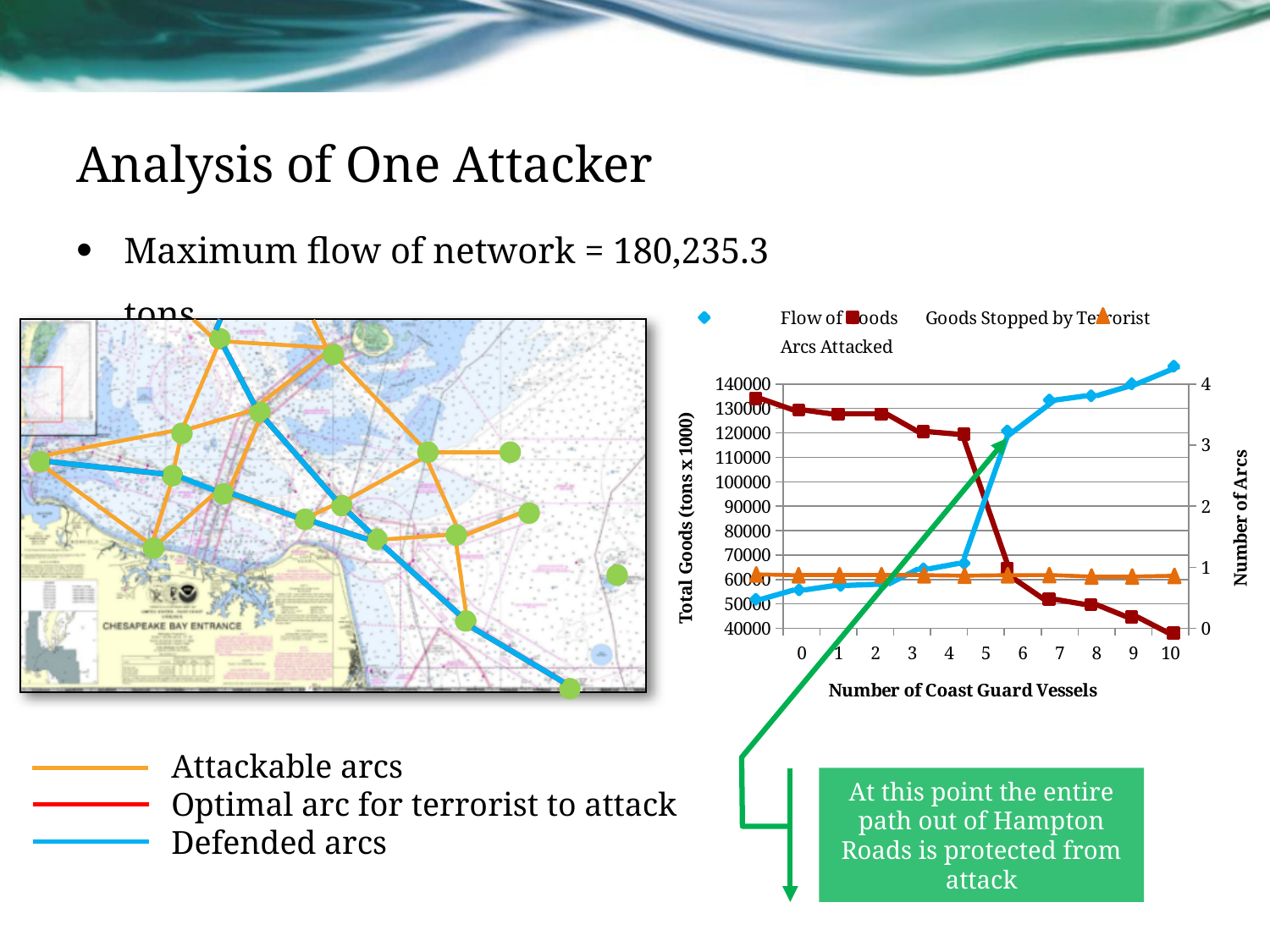
What is the title of the x axis of the chart? Number of Coast Guard Vessels Is the Flow of Goods value at 0 Coast Guard vessels greater or less than 60000? less How many data points does the Flow of Goods series have in the chart? 11 How many series does the legend of the chart list? 3 What is the title of the right-hand y axis of the chart? Number of Arcs What kind of chart is shown on the right side of the slide? line chart Is the Goods Stopped by Terrorist value at 0 Coast Guard vessels greater or less than 120000? greater In the chart, does the Goods Stopped by Terrorist series rise or fall as the number of Coast Guard vessels increases? fall At 10 Coast Guard vessels, which is larger: Flow of Goods or Goods Stopped by Terrorist? Flow of Goods Is the Goods Stopped by Terrorist value at 10 Coast Guard vessels greater or less than 50000? less In the chart, does the Flow of Goods series rise or fall as the number of Coast Guard vessels increases? rise